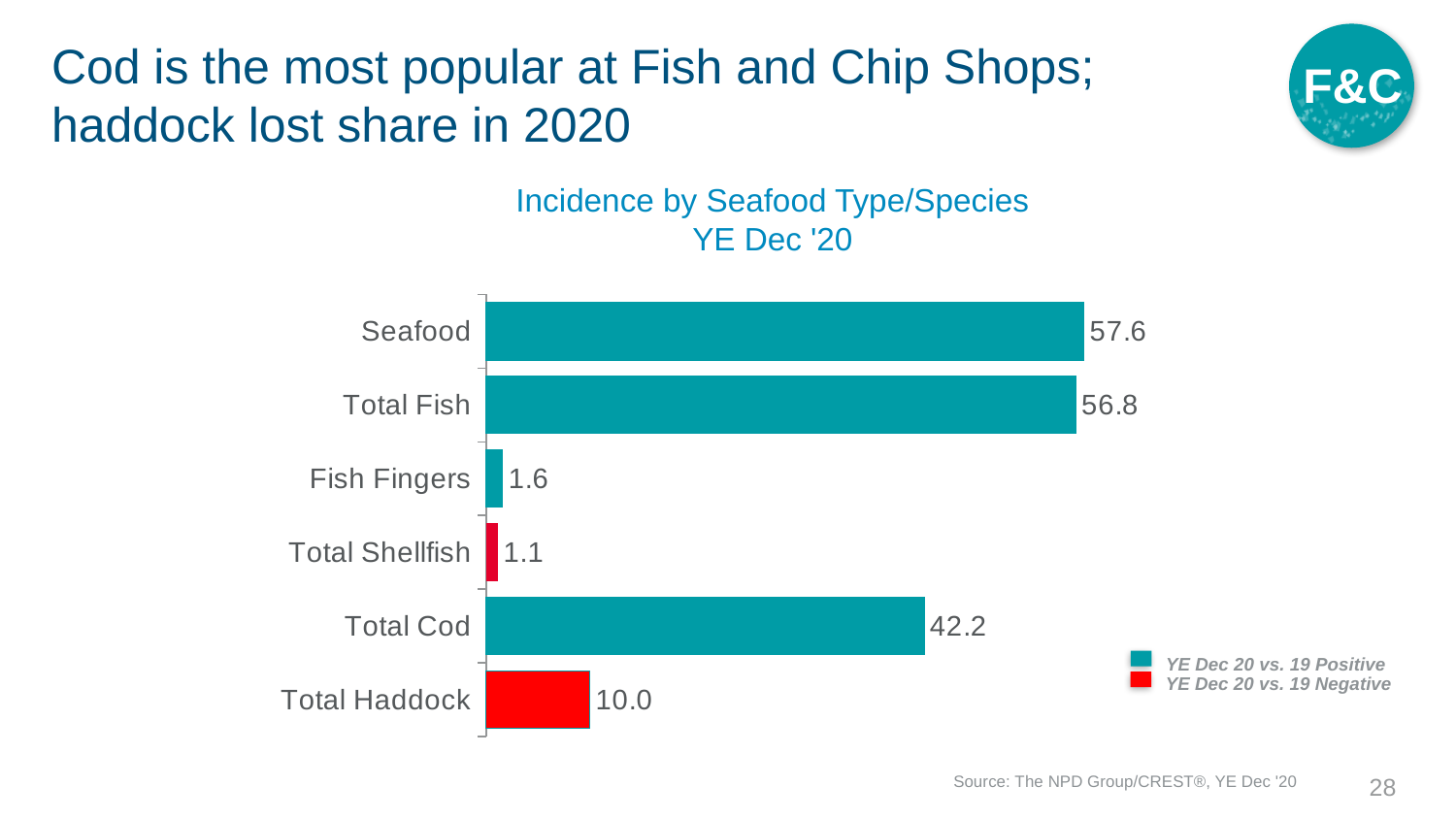
What is the difference between the values for Total Cod and Total Haddock? 32.2 What is the difference between the values for Seafood and Total Fish? 0.8 What kind of chart is shown on the slide? Bar chart What is the value for Total Shellfish? 1.1 What is the value for Total Haddock? 10.0 Which category has the highest value? Seafood Which categories are shown in red, indicating a negative change YE Dec 20 vs. 19? Total Shellfish and Total Haddock What is the value for Fish Fingers? 1.6 How many categories are shown in the chart? 6 Which is larger, the value for Total Cod or the value for Total Haddock? Total Cod What is the value for Total Cod? 42.2 Which category has the lowest value? Total Shellfish